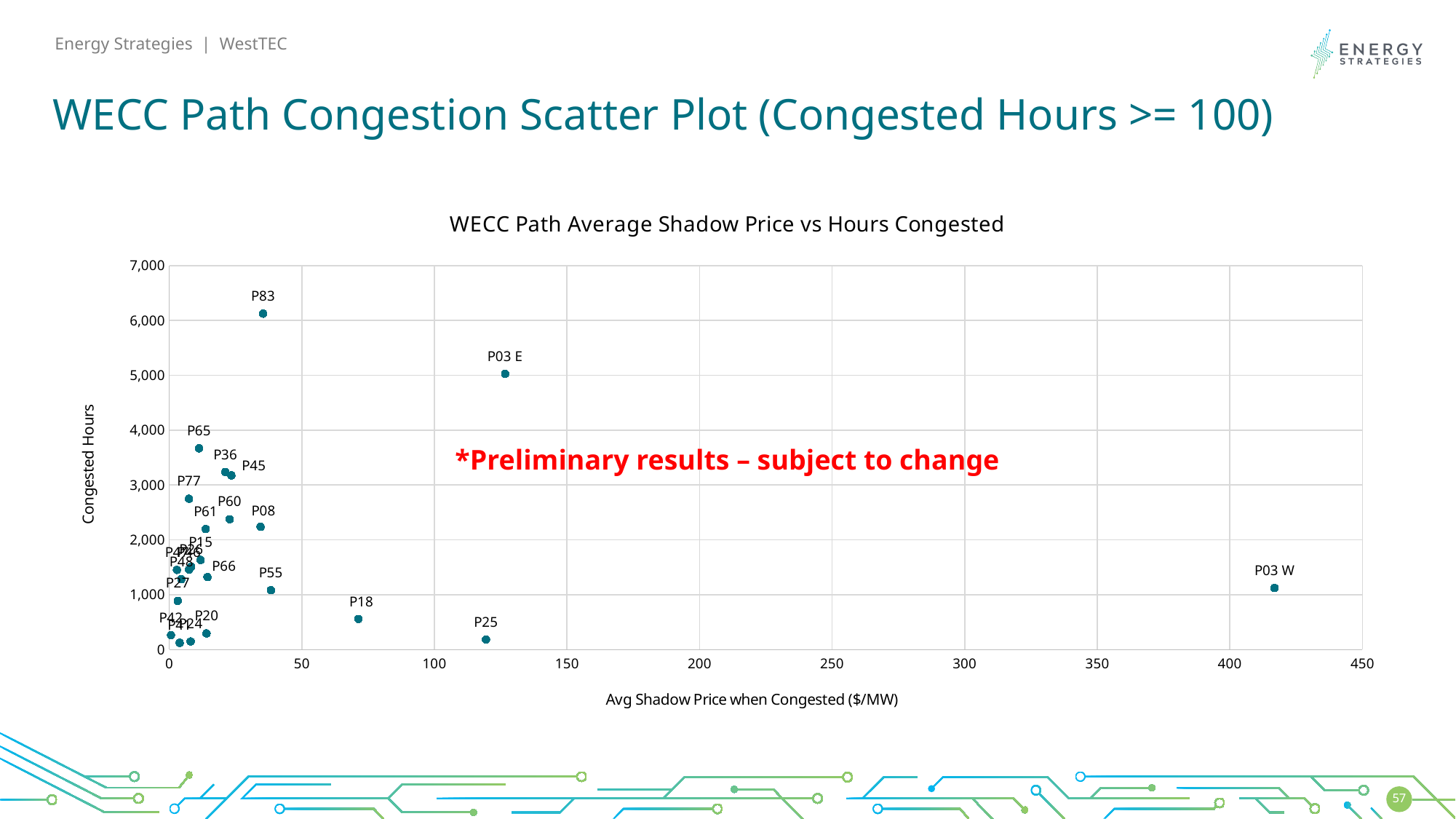
Is the number of congested hours for P03 E greater or less than 4,000? greater Is the number of congested hours for P25 greater or less than 500? less What kind of chart is shown on the slide? Scatter plot Which path has more congested hours, P83 or P03 E? P83 Is the average shadow price for P18 greater or less than 50 $/MW? greater Which path has a higher average shadow price when congested, P03 W or P25? P03 W What is the label of the x axis? Avg Shadow Price when Congested ($/MW) What is the title of the chart? WECC Path Average Shadow Price vs Hours Congested Which path has the highest average shadow price when congested? P03 W Which path has the highest number of congested hours? P83